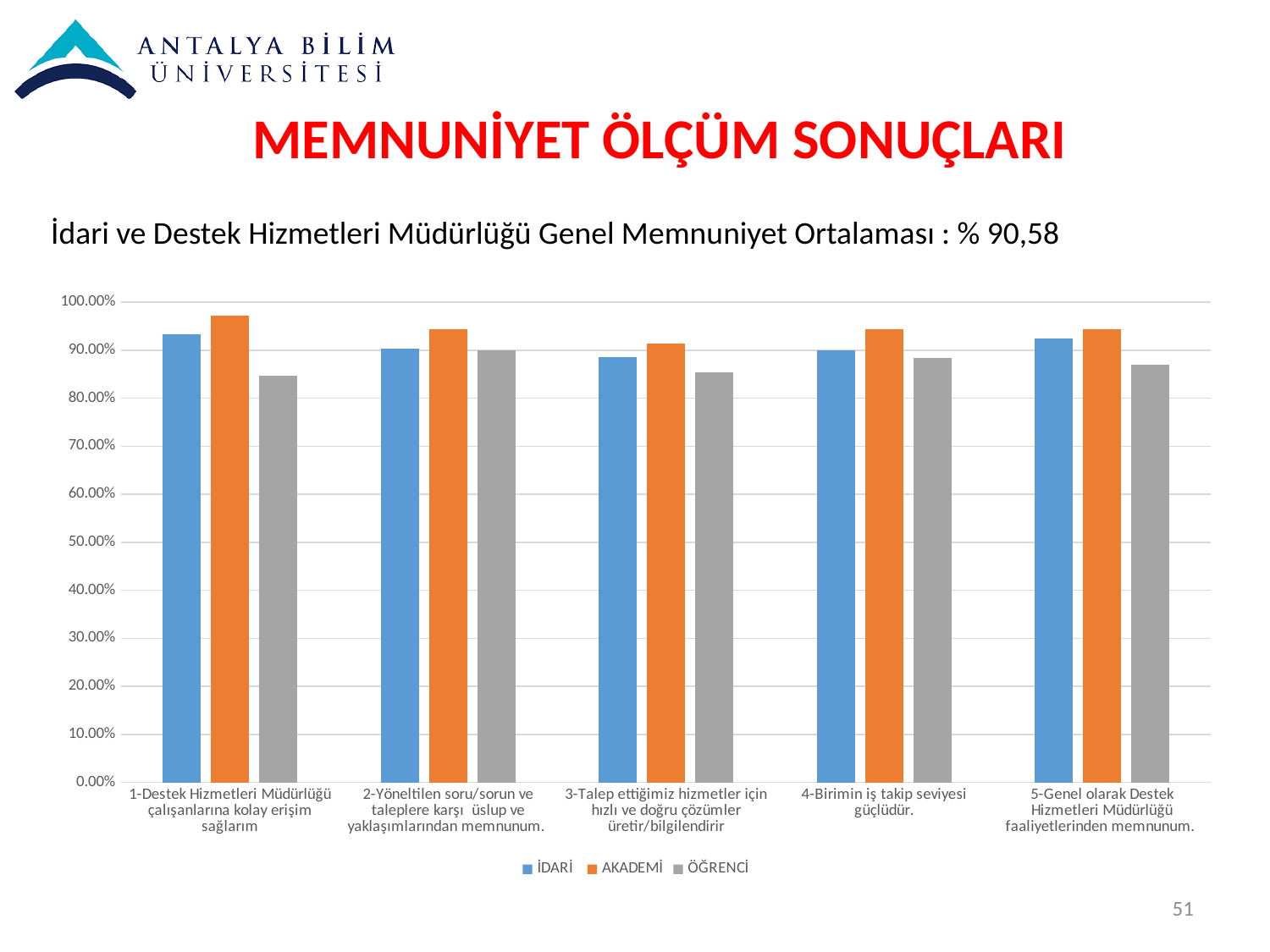
Which colour represents the AKADEMİ series in the chart? orange For the AKADEMİ series, which category has the highest value? 1-Destek Hizmetleri Müdürlüğü çalışanlarına kolay erişim sağlarım For category 1 (Destek Hizmetleri Müdürlüğü çalışanlarına kolay erişim sağlarım), which is larger: the AKADEMİ value or the ÖĞRENCİ value? AKADEMİ What kind of chart is shown on the slide? bar chart What overall satisfaction average (Genel Memnuniyet Ortalaması) is stated above the chart? % 90,58 Which series has the highest value in category 1 (Destek Hizmetleri Müdürlüğü çalışanlarına kolay erişim sağlarım)? AKADEMİ Is the AKADEMİ value for category 1 (Destek Hizmetleri Müdürlüğü çalışanlarına kolay erişim sağlarım) greater or less than 90.00%? greater How many series does the legend list? 3 How many categories (questions) are shown along the x axis? 5 Is the ÖĞRENCİ value for category 1 (Destek Hizmetleri Müdürlüğü çalışanlarına kolay erişim sağlarım) greater or less than 90.00%? less Is the İDARİ value for category 5 (Genel olarak Destek Hizmetleri Müdürlüğü faaliyetlerinden memnunum) greater or less than 90.00%? greater